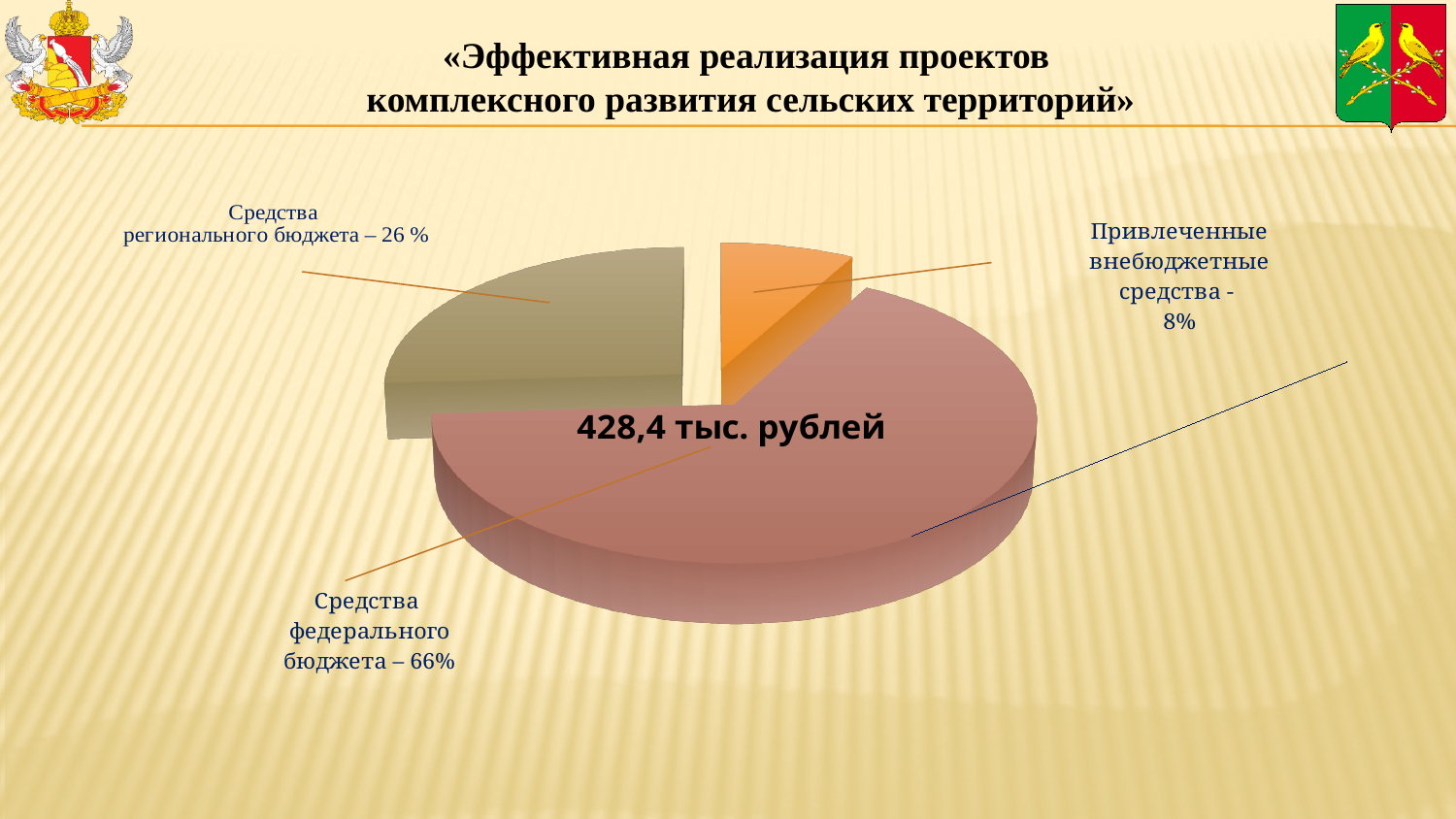
Which slice of the pie chart is the largest? Средства федерального бюджета By how many percentage points does the federal budget share exceed the regional budget share? 40 By how many percentage points does the regional budget share exceed the extra-budgetary share? 18 What share of the pie is labelled «Средства федерального бюджета»? 66% How many slices does the pie chart have? 3 What total amount is printed in the centre of the pie chart? 428,4 тыс. рублей What is the title shown above the chart on the slide? «Эффективная реализация проектов комплексного развития сельских территорий» What kind of chart is shown on the slide? pie chart What share of the pie is labelled «Привлеченные внебюджетные средства»? 8% Which is larger: the share of regional budget funds or the share of extra-budgetary funds? Средства регионального бюджета Which slice of the pie chart is the smallest? Привлеченные внебюджетные средства What share of the pie is labelled «Средства регионального бюджета»? 26 %